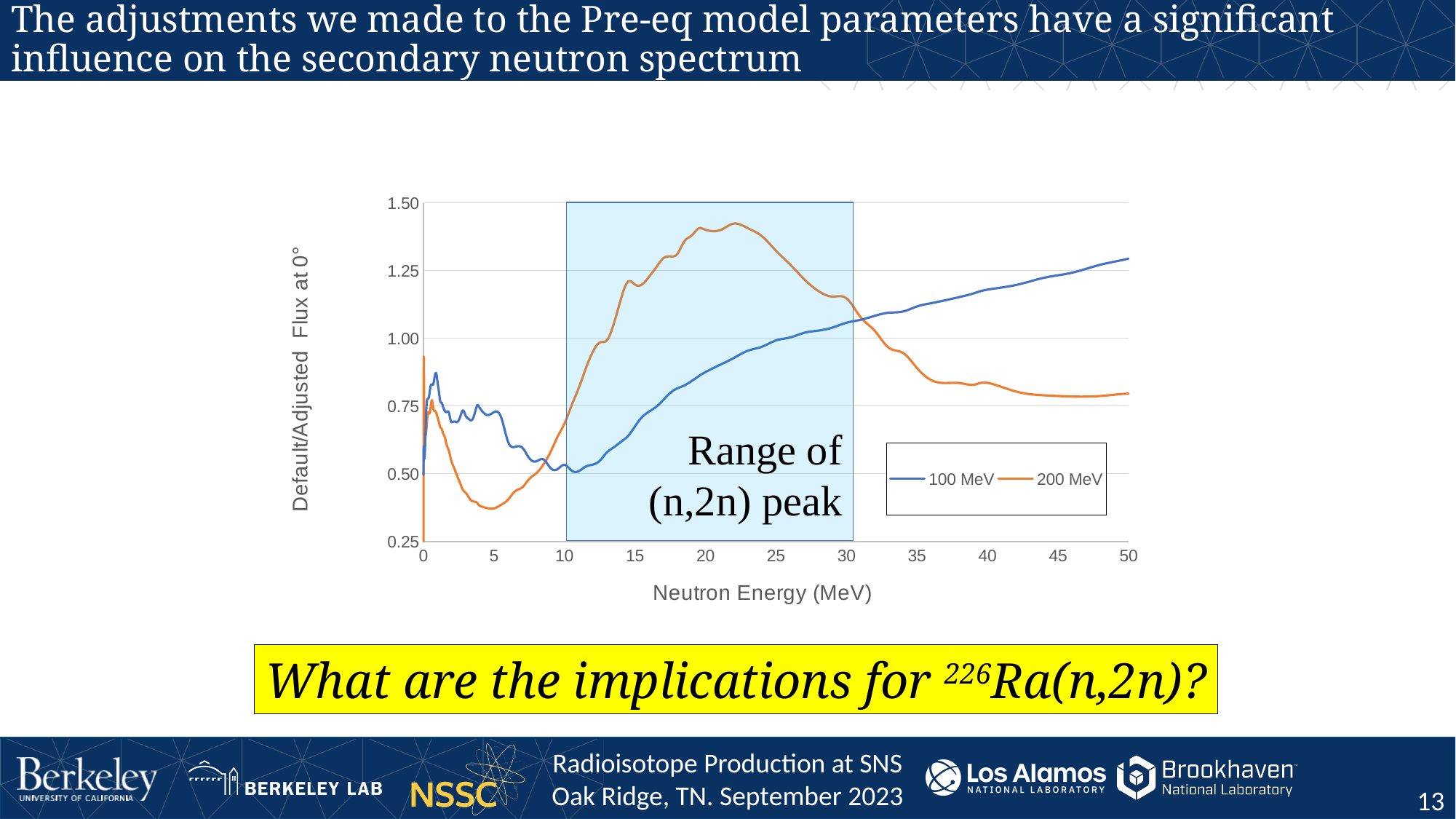
What kind of chart is shown on the slide? line chart Is the value of the 200 MeV series at 5 MeV neutron energy greater or less than 0.50? less At 20 MeV neutron energy, which series has the larger value, 100 MeV or 200 MeV? 200 MeV Does the 100 MeV series rise or fall as neutron energy increases from 10 MeV to 50 MeV? rise Is the value of the 200 MeV series at 40 MeV neutron energy greater or less than 1.00? less What label is written inside the shaded region of the chart? Range of (n,2n) peak Does the 200 MeV series rise or fall as neutron energy increases from 25 MeV to 45 MeV? fall Is the value of the 200 MeV series at 20 MeV neutron energy greater or less than 1.25? greater What are the two series named in the legend? 100 MeV and 200 MeV How many series does the legend list? 2 At 45 MeV neutron energy, which series has the larger value, 100 MeV or 200 MeV? 100 MeV